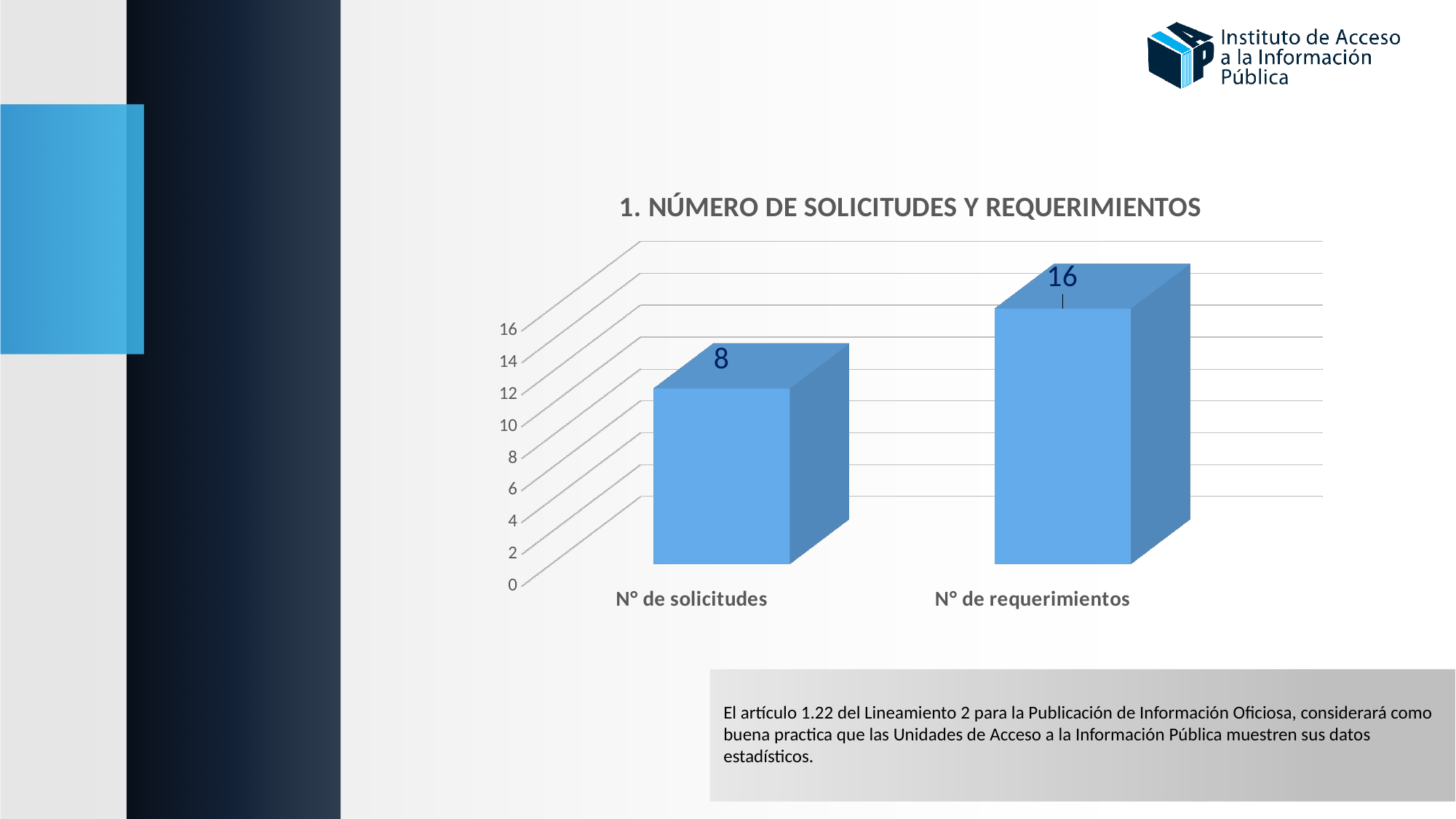
Is the value for N° de requerimientos greater or less than 10? greater Which is larger, the value for N° de solicitudes or the value for N° de requerimientos? N° de requerimientos What is the highest value shown on the vertical axis? 16 What is the value for N° de solicitudes? 8 What is the title of the chart? 1. NÚMERO DE SOLICITUDES Y REQUERIMIENTOS Which category has the highest value? N° de requerimientos Is the value for N° de solicitudes greater or less than 12? less What is the value for N° de requerimientos? 16 How many categories are shown in the chart? 2 What kind of chart is shown on the slide? Bar chart What is the difference between the value for N° de requerimientos and the value for N° de solicitudes? 8 Which category has the lowest value? N° de solicitudes